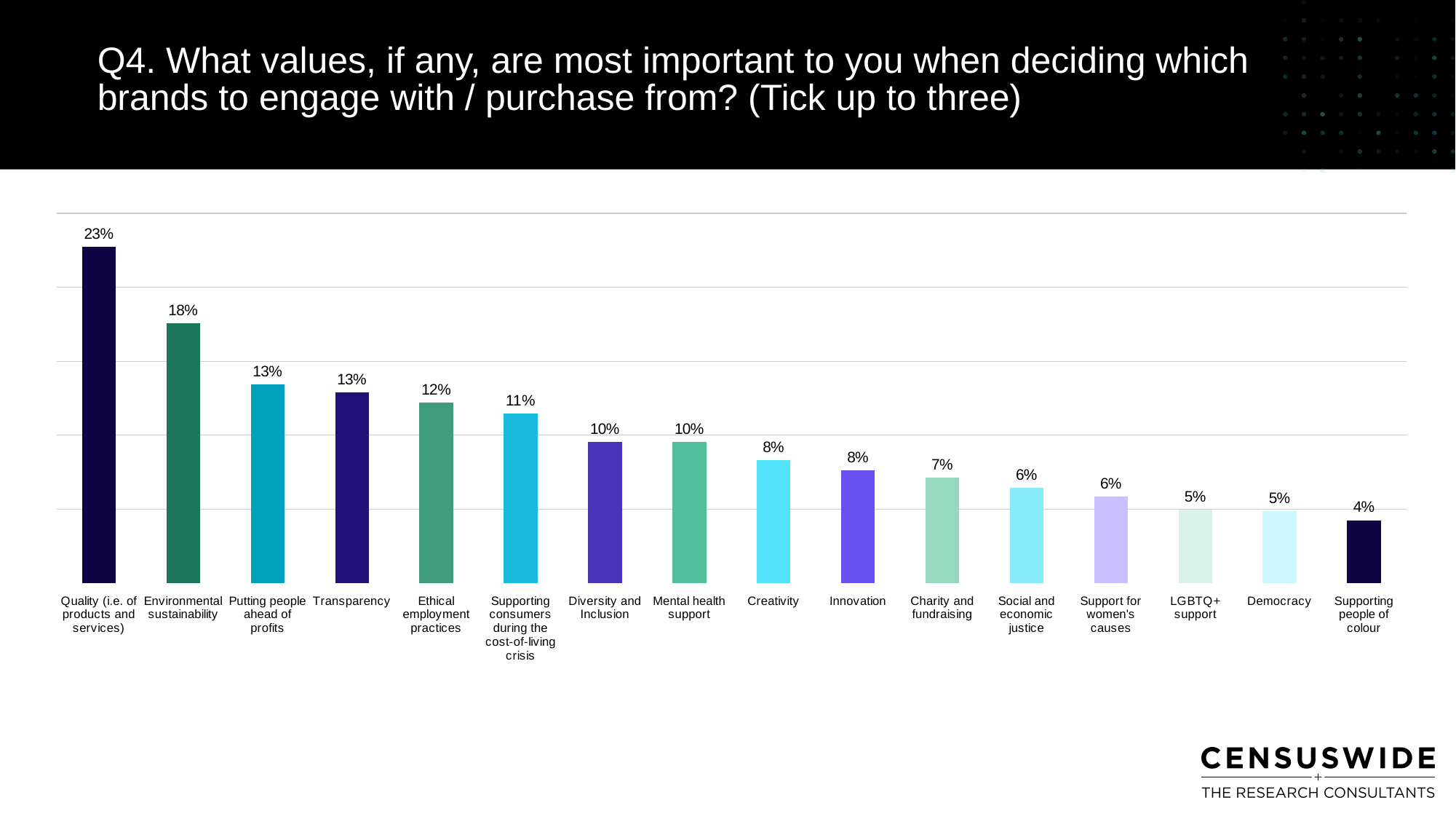
What is the value for Supporting consumers during the cost-of-living crisis? 11% What percentage of respondents chose Quality (i.e. of products and services)? 23% What is the difference between the values for Quality (i.e. of products and services) and Environmental sustainability? 5% What kind of chart is shown on the slide? Bar chart What is the difference between the values for Ethical employment practices and Innovation? 4% What is the value for Environmental sustainability? 18% How many categories are shown in the chart? 16 Which category has the lowest value? Supporting people of colour What is the value for Democracy? 5% Do the values rise or fall from left to right across the categories? Fall Which is larger, the value for Creativity or the value for Charity and fundraising? Creativity Which category has the highest value? Quality (i.e. of products and services)